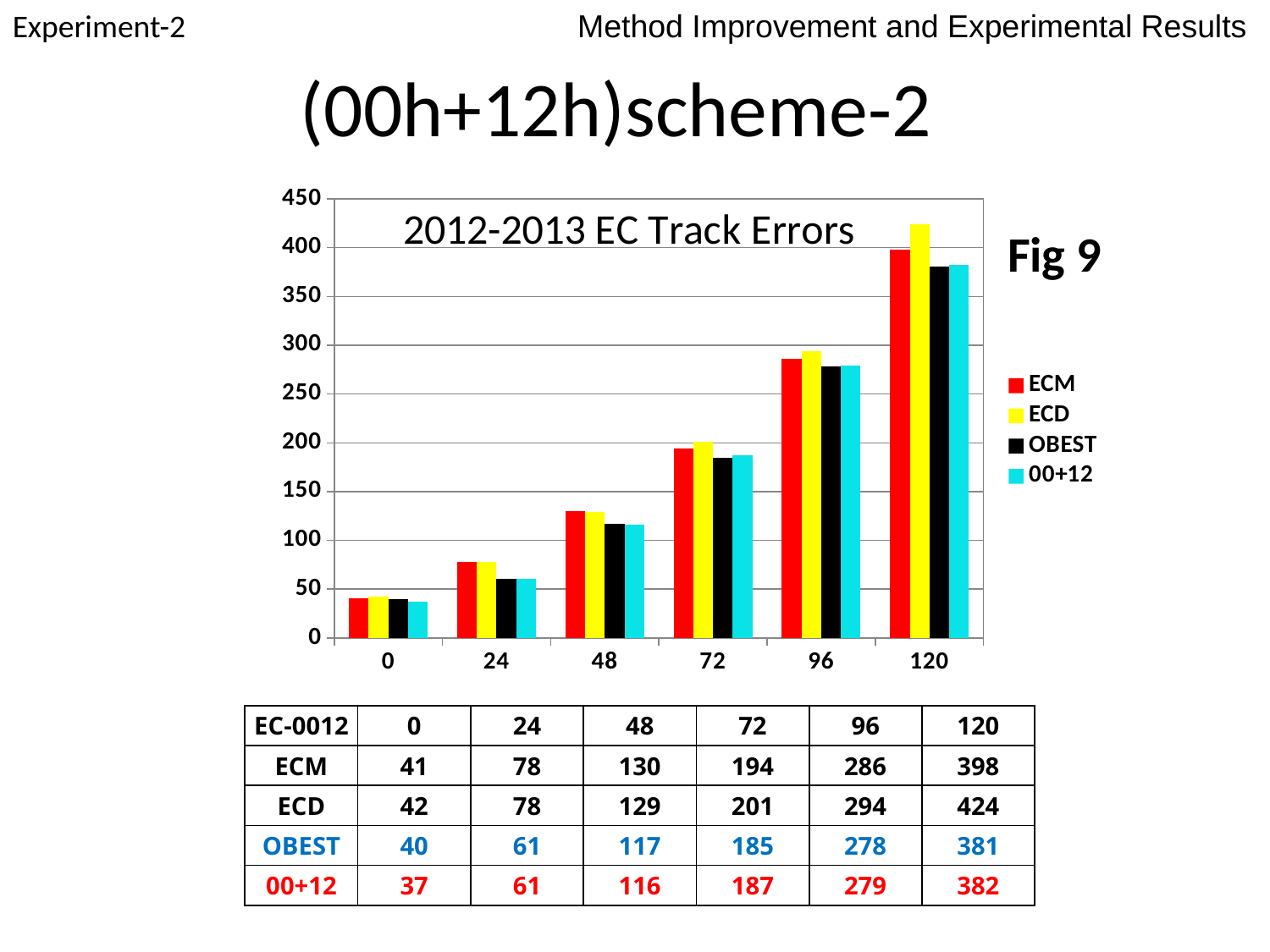
What is the 00+12 value at 96 in the 2012-2013 EC Track Errors chart? 279 Which series has the highest value at 120 in the 2012-2013 EC Track Errors chart? ECD What is the difference between the ECD and OBEST values at 120 in the 2012-2013 EC Track Errors chart? 43 At 72, which is larger in the 2012-2013 EC Track Errors chart: ECM or OBEST? ECM Which series has the lowest value at 0 in the 2012-2013 EC Track Errors chart? 00+12 How many series does the legend of the 2012-2013 EC Track Errors chart list? 4 What is the ECD value at 72 in the 2012-2013 EC Track Errors chart? 201 Do the ECM values rise or fall as the x axis goes from 0 to 120 in the 2012-2013 EC Track Errors chart? rise What type of chart is the 2012-2013 EC Track Errors chart? bar chart How many x-axis categories are shown in the 2012-2013 EC Track Errors chart? 6 What is the ECM value at 120 in the 2012-2013 EC Track Errors chart? 398 What is the OBEST value at 48 in the 2012-2013 EC Track Errors chart? 117